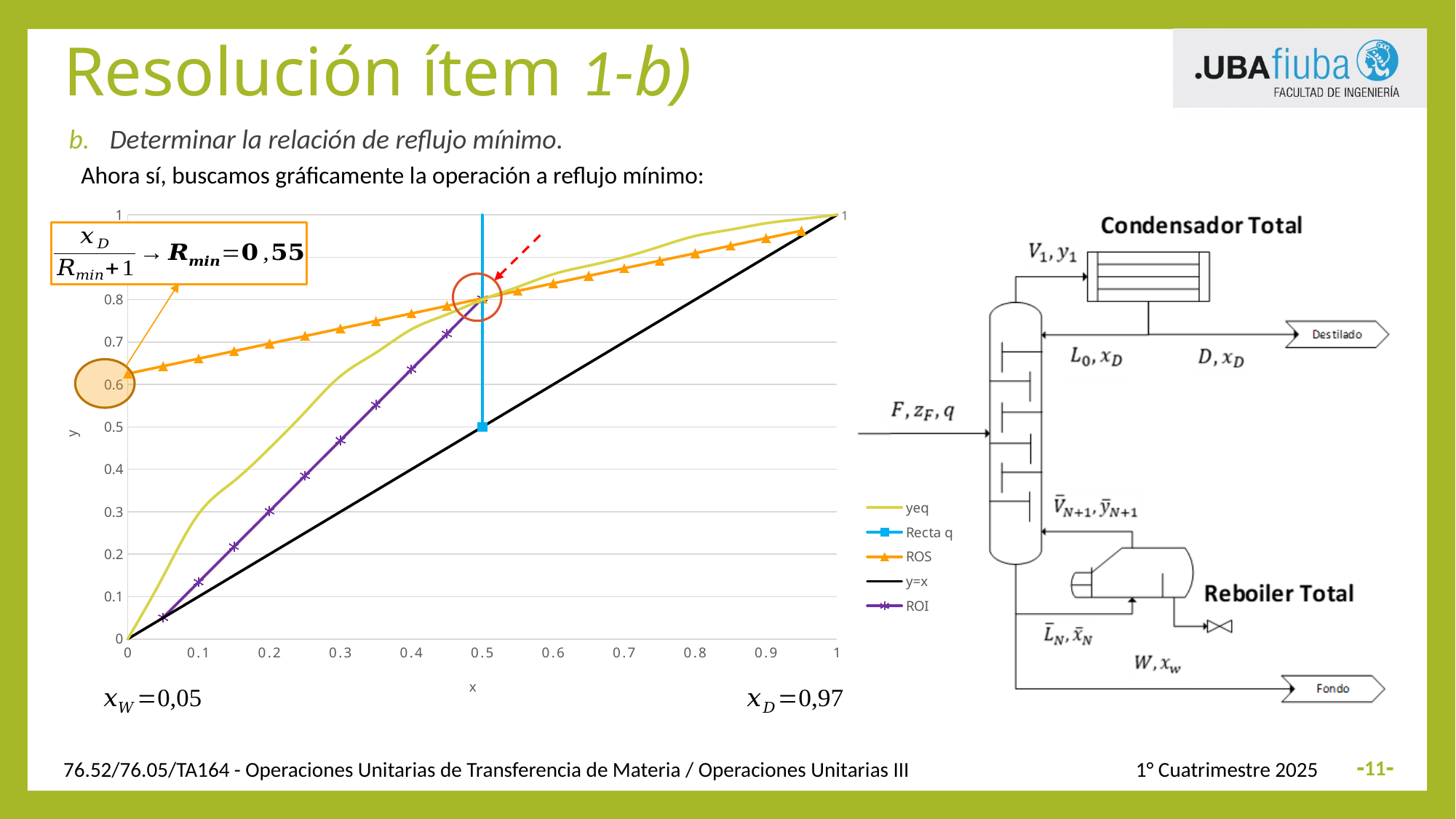
Does the yeq curve rise or fall as x increases from 0 to 1? rise What are the series names listed in the chart legend? yeq, Recta q, ROS, y=x, ROI Which series has the highest y value at x = 0.1? ROS At x = 0.2, which series has the higher y value, ROS or ROI? ROS Is the y value of the yeq curve at x = 0.5 greater or less than 0.7? greater What are the labels of the x axis and y axis of the chart? x and y At x = 0.3, which series has the higher y value, yeq or ROI? yeq How many series does the chart legend list? 5 Is the y value of the ROI line at x = 0.1 greater or less than 0.1? greater What kind of chart is shown on the slide? line chart Is the y value of the ROS line at x = 0 greater or less than 0.5? greater At what x value is the vertical Recta q line located? 0.5